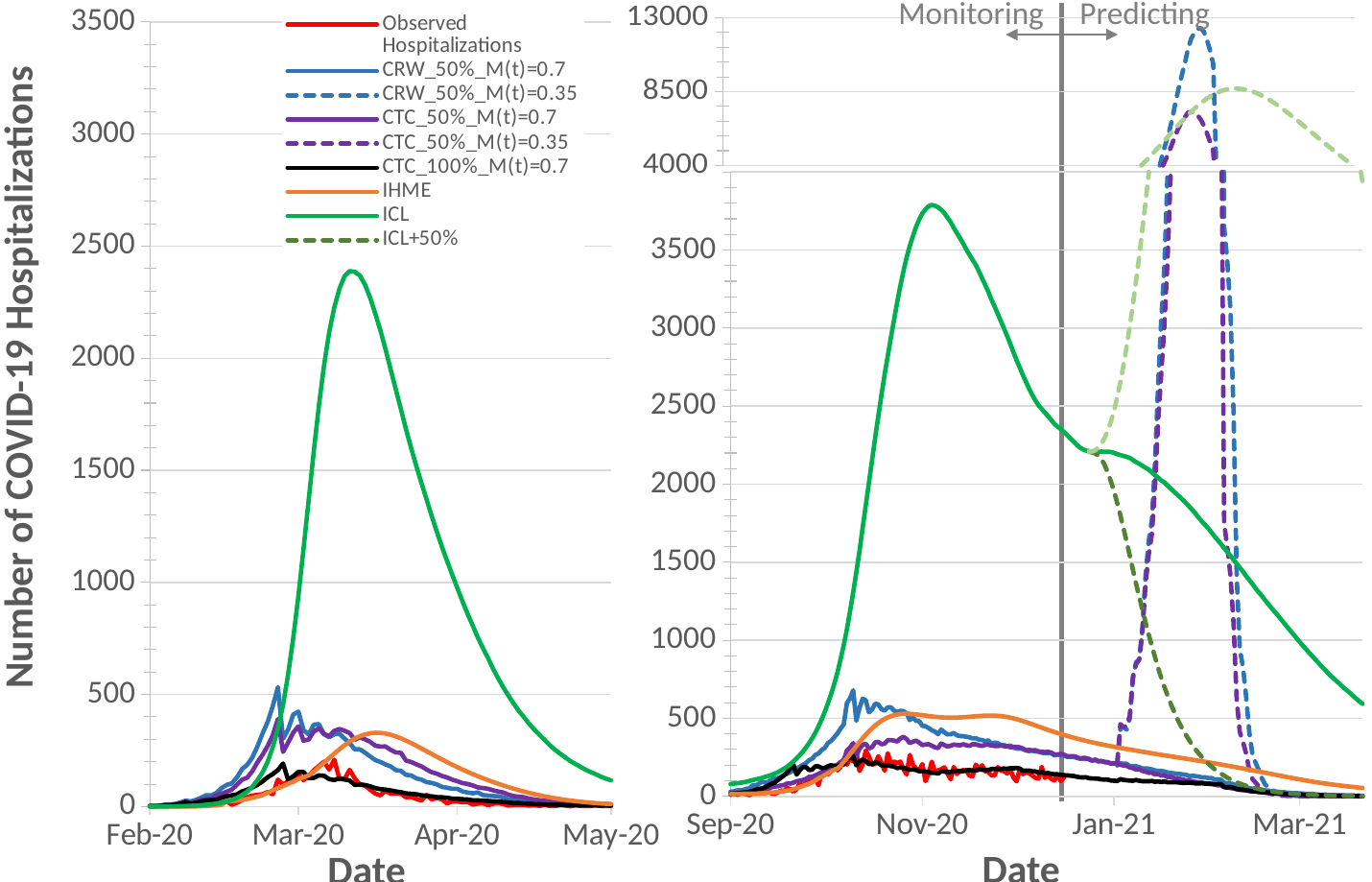
How many date labels are shown on the x axis of the right chart? 4 In the left chart, is the peak value of the IHME series greater or less than 500? less In the left chart, is the peak value of the ICL series greater or less than 2000? greater In the right chart, is the peak value of the CRW_50%_M(t)=0.35 series greater or less than 8500? greater What is the title of the y axis? Number of COVID-19 Hospitalizations How many series does the legend list? 9 In the right chart, does the ICL series rise or fall from Nov-20 to Mar-21? fall In the right chart, which peaks higher, the ICL series or the ICL+50% series? ICL+50% In the left chart, which peaks higher, the ICL series or the IHME series? ICL In the left chart, which series reaches the highest peak? ICL What kind of chart is the left chart? line chart